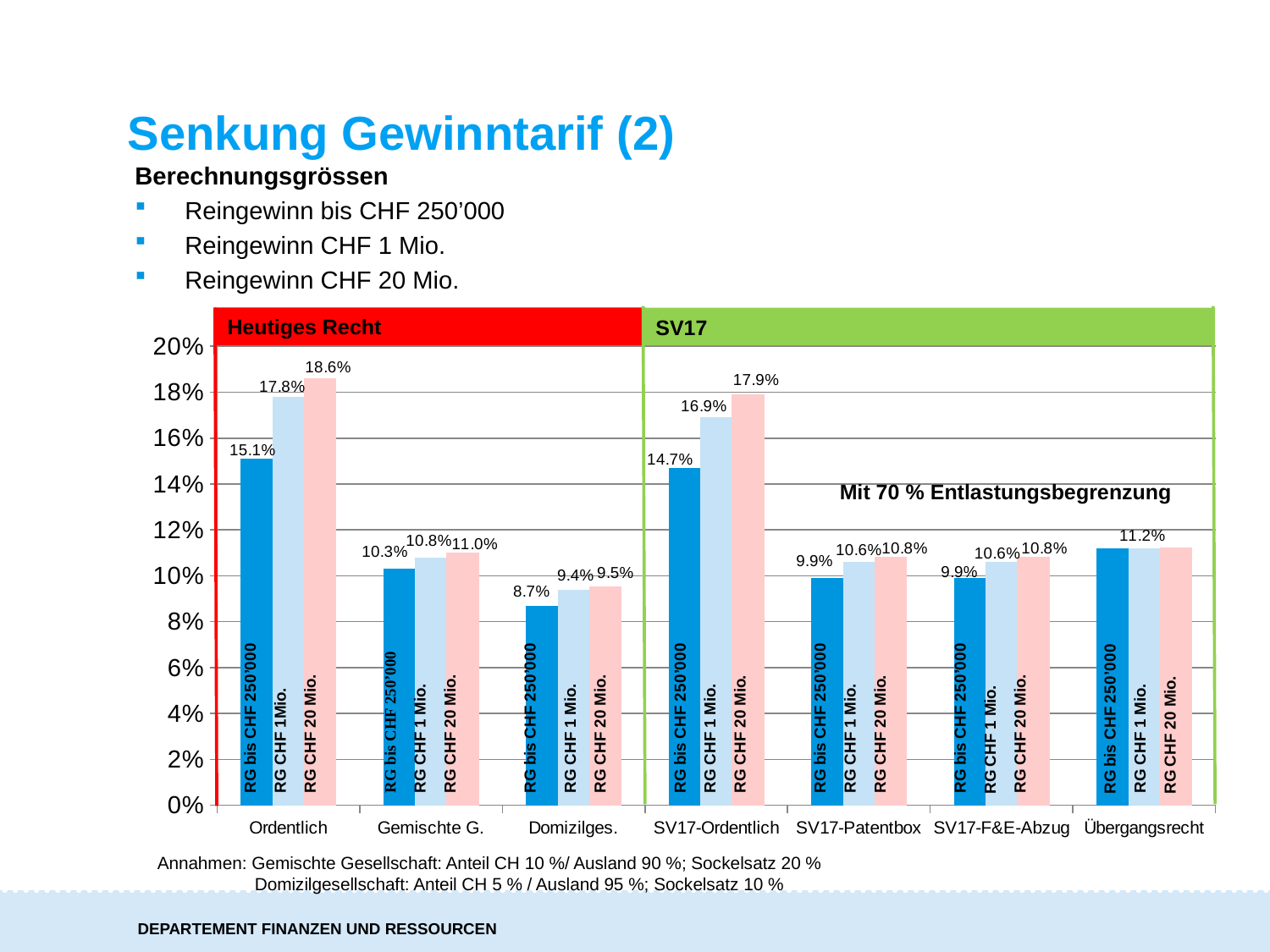
What is the value for RG CHF 20 Mio. in the Ordentlich category? 18.6% Is the value for RG bis CHF 250'000 in the Übergangsrecht category greater or less than 10%? greater What is the value for RG bis CHF 250'000 in the SV17-Ordentlich category? 14.7% Which bar has the lowest value in the chart? RG bis CHF 250'000 in Domizilges. (8.7%) What is the value for RG CHF 20 Mio. in the SV17-Patentbox category? 10.8% What is the value for RG bis CHF 250'000 in the Domizilges. category? 8.7% What is the difference between the RG CHF 20 Mio. value for Ordentlich and the RG CHF 20 Mio. value for SV17-Ordentlich? 0.7 percentage points Which is larger: the RG CHF 1 Mio. value for Gemischte G. or the RG CHF 1 Mio. value for SV17-Patentbox? Gemischte G. How many categories are shown on the x axis of the chart? 7 Which bar has the highest value in the chart? RG CHF 20 Mio. in Ordentlich (18.6%) What is the difference between the RG CHF 1 Mio. value and the RG bis CHF 250'000 value in the Ordentlich category? 2.7 percentage points What kind of chart is shown on the slide? bar chart